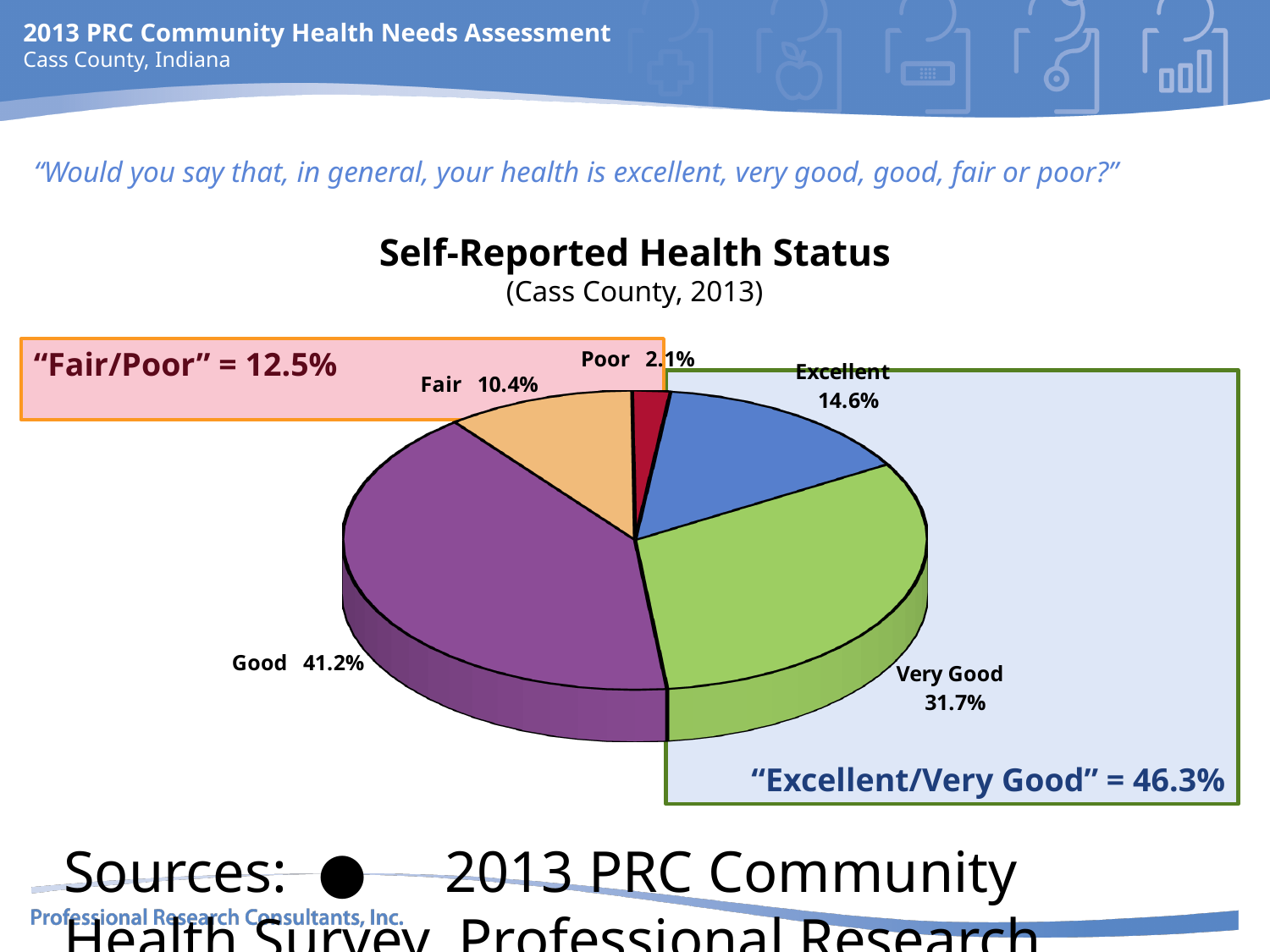
What is the combined percentage for "Excellent/Very Good" shown on the slide? 46.3% What percentage of respondents reported their health as Poor? 2.1% Which health status category has the smallest share of the pie? Poor What is the difference in percentage points between Very Good and Excellent? 17.1 What percentage of respondents reported their health as Fair? 10.4% Which health status category has the largest share of the pie? Good What percentage of respondents reported their health as Excellent? 14.6% How many categories are shown in the pie chart? 5 Which is larger, the share for Fair or the share for Excellent? Excellent What percentage of respondents reported their health as Good? 41.2% What type of chart is shown on the slide? Pie chart What is the title of the chart? Self-Reported Health Status